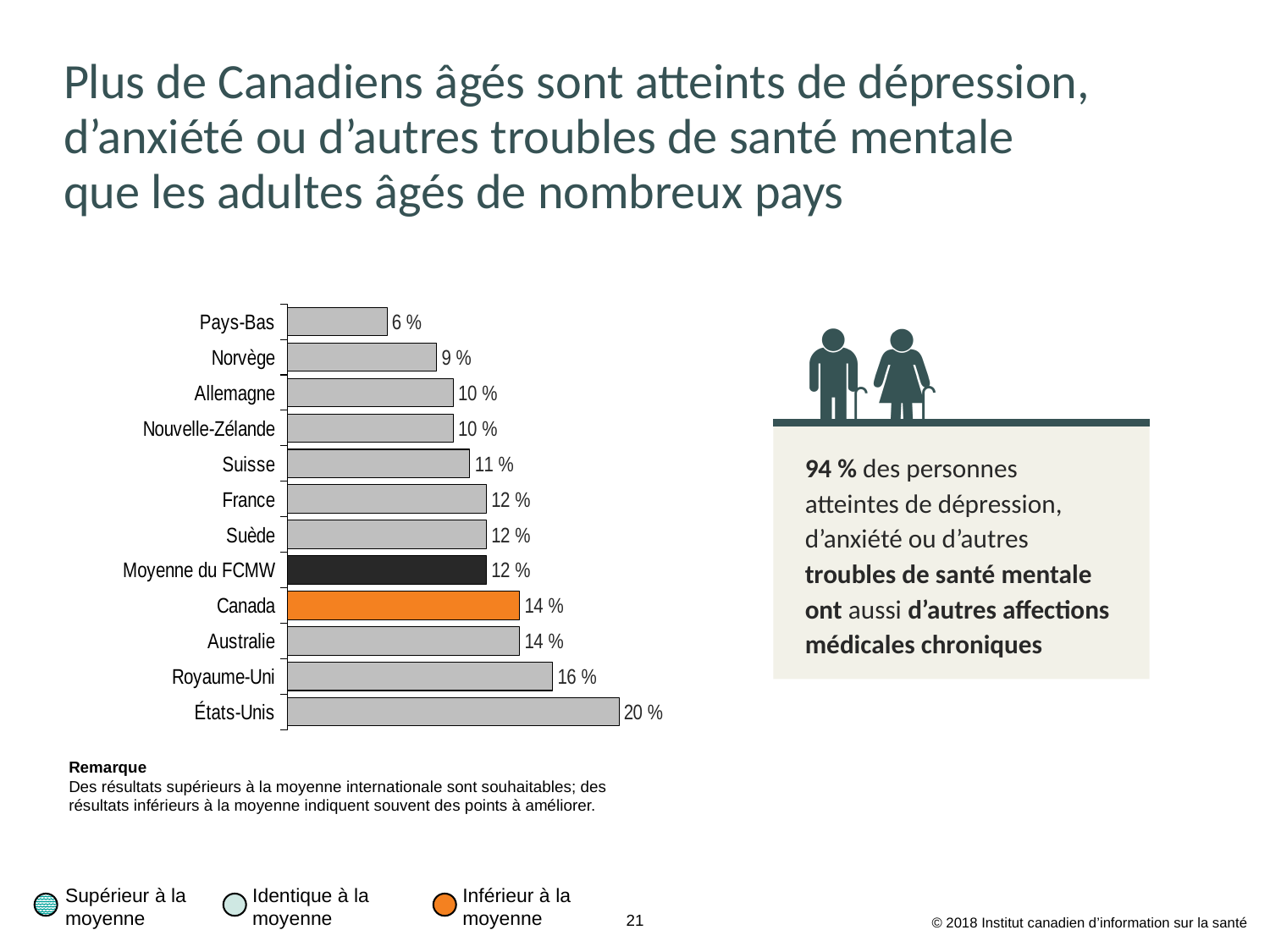
Which bar is coloured orange? Canada Which country has the lowest value? Pays-Bas What kind of chart is shown on the slide? Bar chart Which is larger, the value for Royaume-Uni or the value for Suisse? Royaume-Uni What is the difference between the values for États-Unis and Pays-Bas? 14 % What is the difference between the values for Canada and Moyenne du FCMW? 2 % What is the value for Norvège? 9 % What is the value for Pays-Bas? 6 % What is the value for Canada? 14 % What is the value for Moyenne du FCMW? 12 % How many bars are shown in the chart? 12 Which country has the highest value? États-Unis